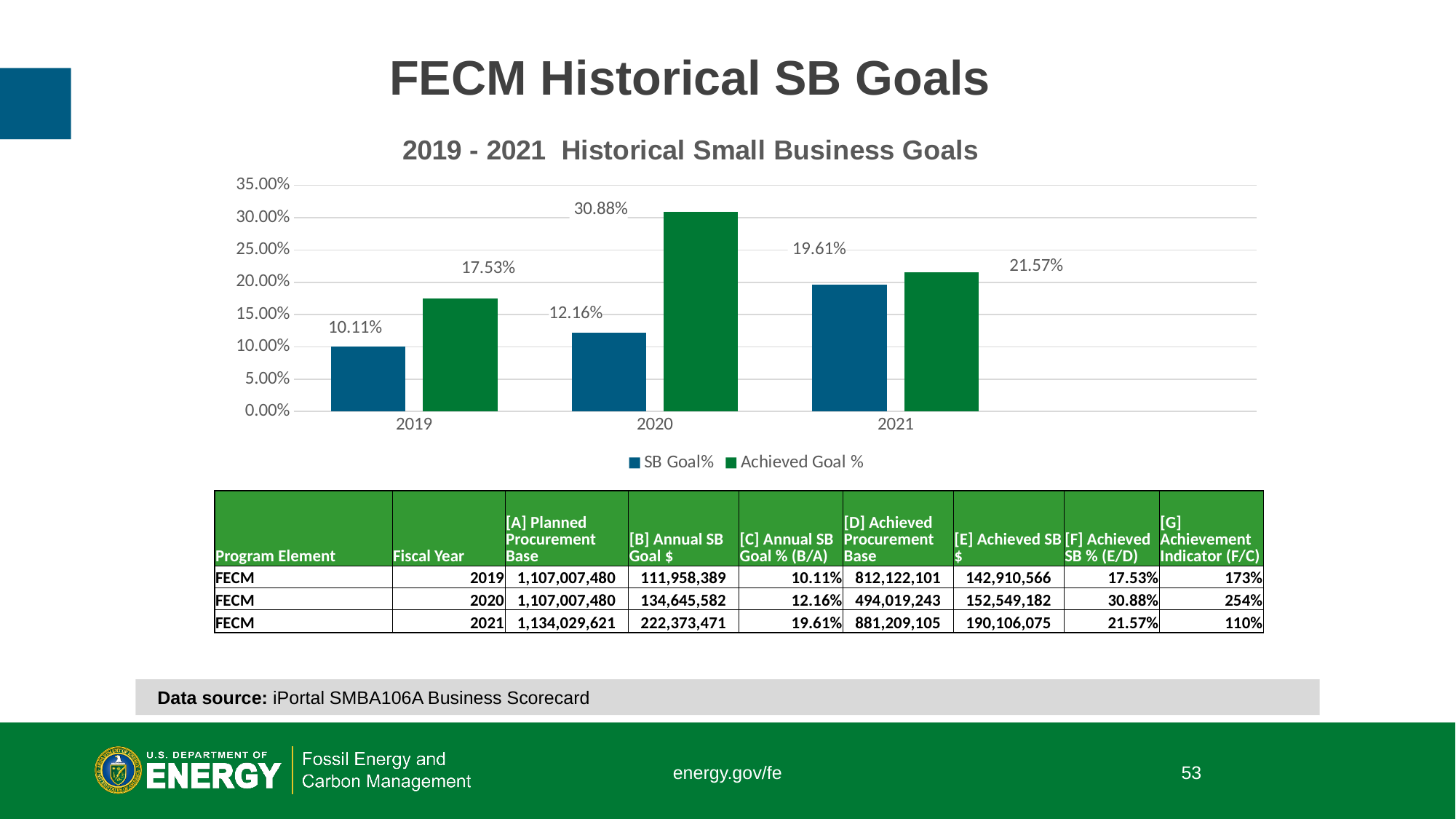
What is the Achieved Goal % for 2021? 21.57% Which year has the highest Achieved Goal %? 2020 Which year has the lowest SB Goal%? 2019 How many series does the chart legend list? 2 How many years are shown on the x axis of the chart? 3 What kind of chart is shown on the slide? Bar chart What is the Achieved Goal % for 2020? 30.88% Which is larger in 2019, the SB Goal% or the Achieved Goal %? Achieved Goal % Does the SB Goal% rise or fall from 2019 to 2021? Rise What is the SB Goal% for 2021? 19.61% What is the SB Goal% for 2019? 10.11% What is the difference between the Achieved Goal % and the SB Goal% in 2020? 18.72%